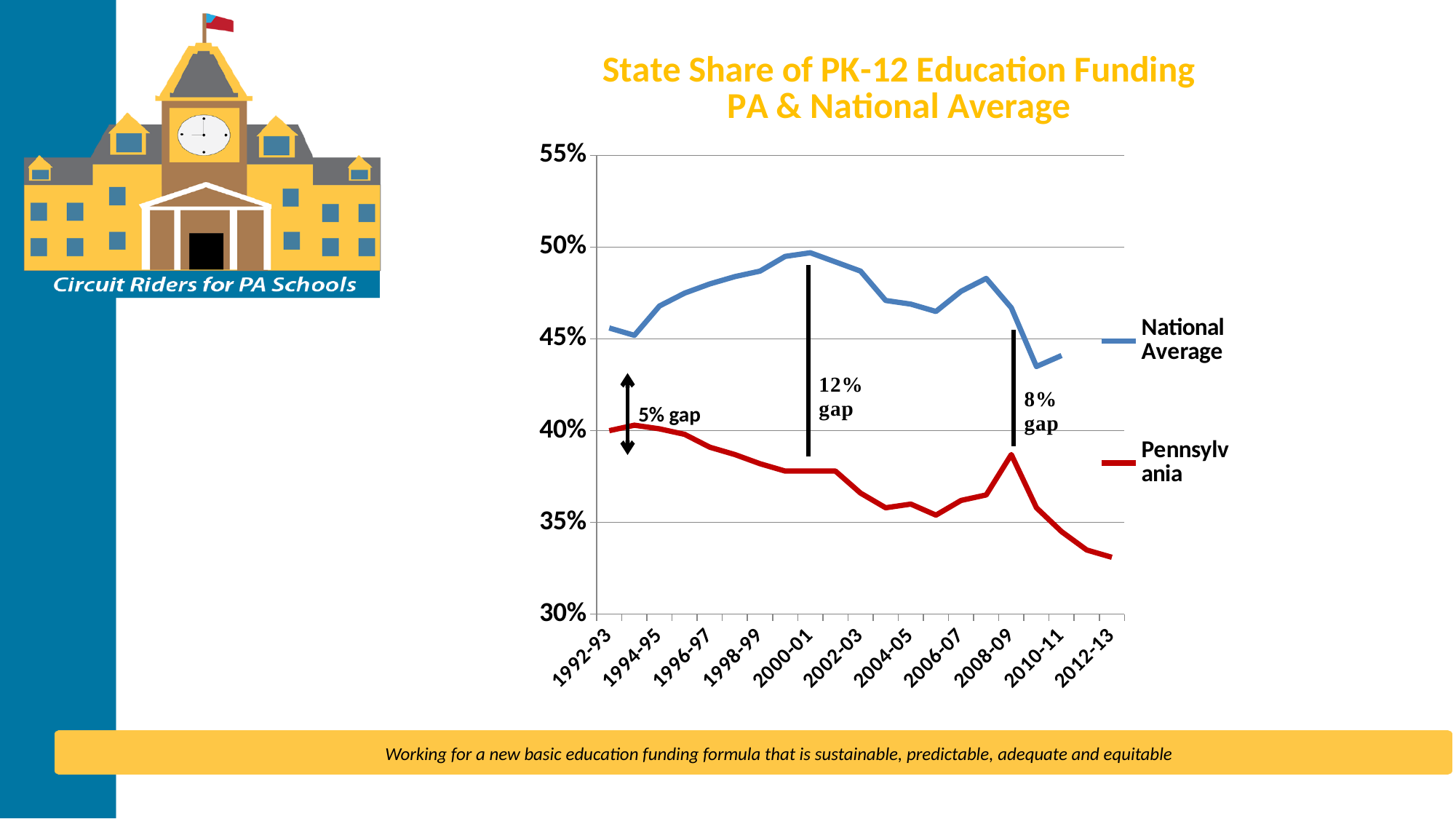
How many year labels are shown on the x axis? 11 Does the Pennsylvania series overall rise or fall from 1992-93 to 2012-13? fall Is the value for Pennsylvania in 2012-13 greater or less than 35%? less Is the value for National Average in 2000-01 greater or less than 45%? greater Which series has the higher value in 2000-01, National Average or Pennsylvania? National Average What kind of chart is shown on the slide? line chart How many series does the legend list? 2 Is the value for National Average in 2010-11 greater or less than 45%? less In which year does the Pennsylvania series reach its lowest value? 2012-13 What gap is annotated between the two lines around 2000-01? 12% gap What are the two series named in the legend? National Average and Pennsylvania